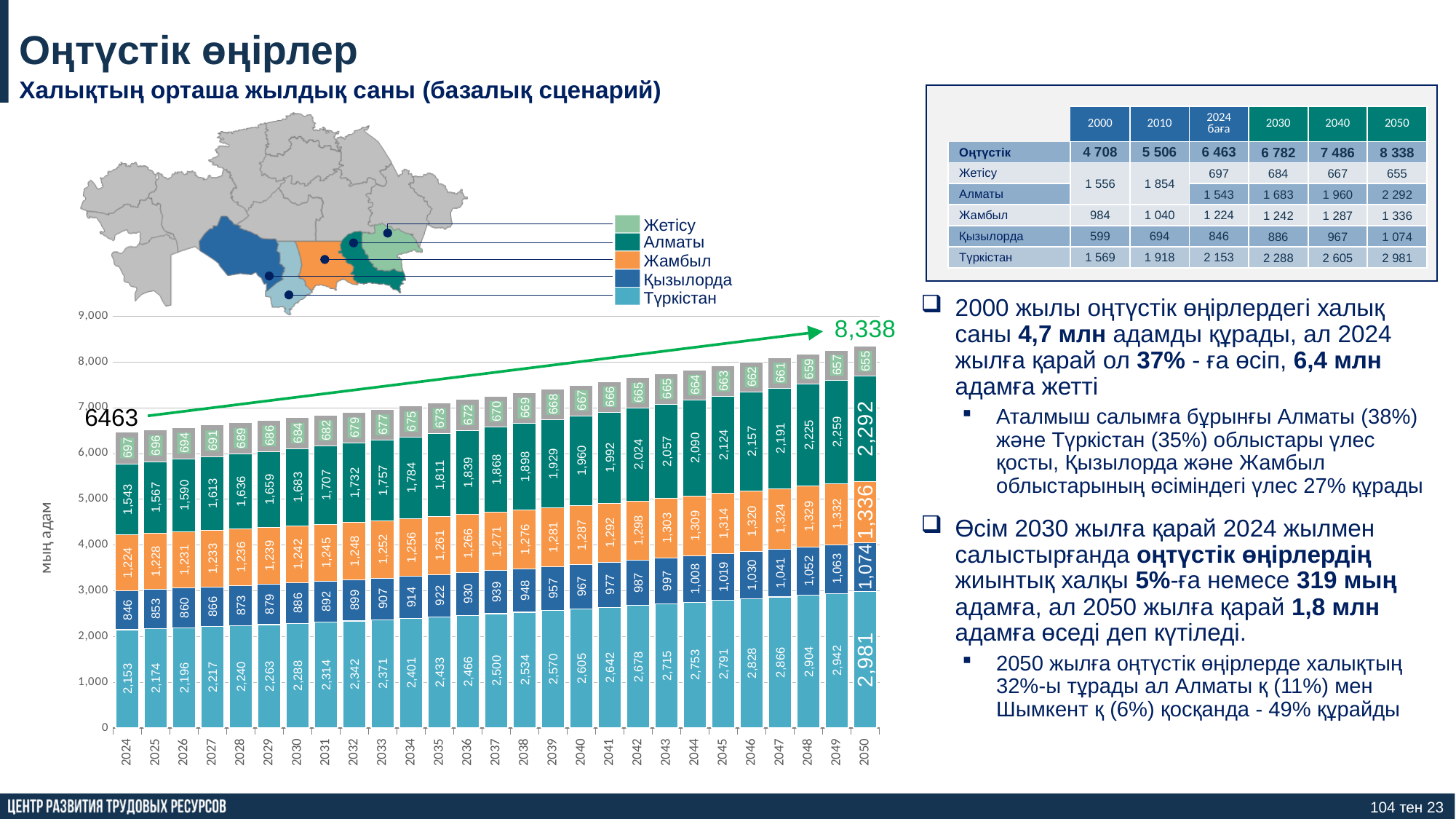
What is the value for Қызылорда in 2030? 886 How many years (bars) are plotted on the x axis of the chart? 27 Which series has the smallest value in the 2024 bar? Жетісу How many series does the chart legend list? 5 Which series has the largest value in the 2050 bar? Түркістан By how much does the value for Түркістан increase from 2024 to 2050? 828 What is the total of the stacked bar for 2050? 8,338 What is the value for Алматы in 2045? 2,124 Do the values for Жетісу rise or fall from 2024 to 2050? Fall What is the value for Жамбыл in 2035? 1,261 What is the value for Түркістан in 2024? 2,153 What kind of chart is shown on the slide? Stacked bar chart